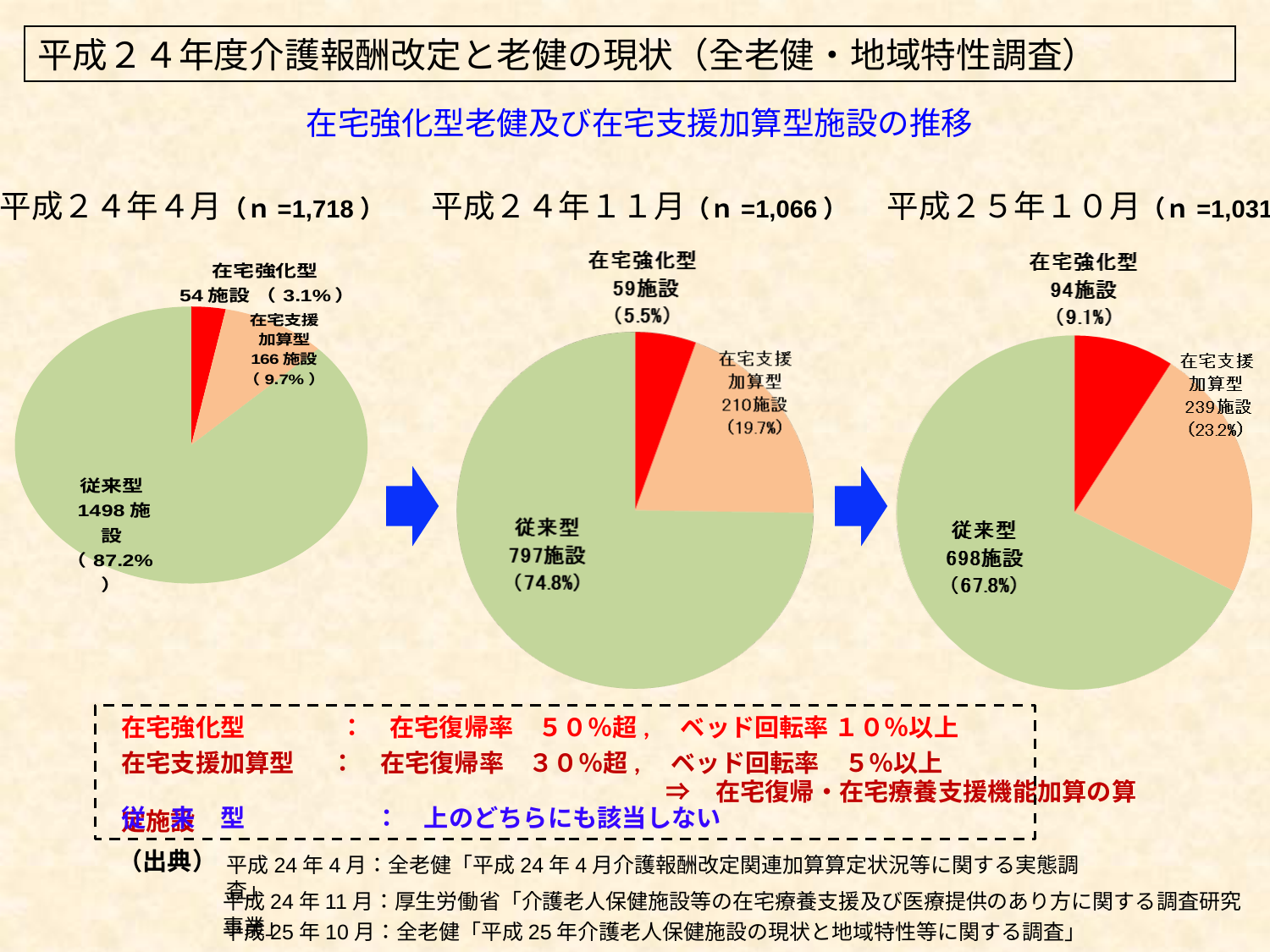
What kind of chart is used on this slide for each of the three time points? Pie chart In the 平成25年10月 pie chart, which category has the smallest slice? 在宅強化型 In the 平成24年11月 pie chart, how many facilities are 在宅支援加算型? 210施設 In the 平成25年10月 pie chart, what share of the pie is 在宅支援加算型? 23.2% In the 平成24年11月 pie chart, which category has the largest slice? 従来型 In the 平成25年10月 pie chart, what is the difference in facility count between 在宅支援加算型 and 在宅強化型? 145施設 In the 平成25年10月 pie chart, how many facilities are 従来型? 698施設 In the 平成24年4月 pie chart, what share of the pie is 従来型? 87.2% In the 平成24年11月 pie chart, what percentage is 在宅強化型? 5.5% How many slices does each pie chart on the slide have? 3 In the 平成24年4月 pie chart, how many facilities are 在宅強化型? 54施設 Across the three pie charts from 平成24年4月 to 平成25年10月, does the share of 従来型 rise or fall? Fall